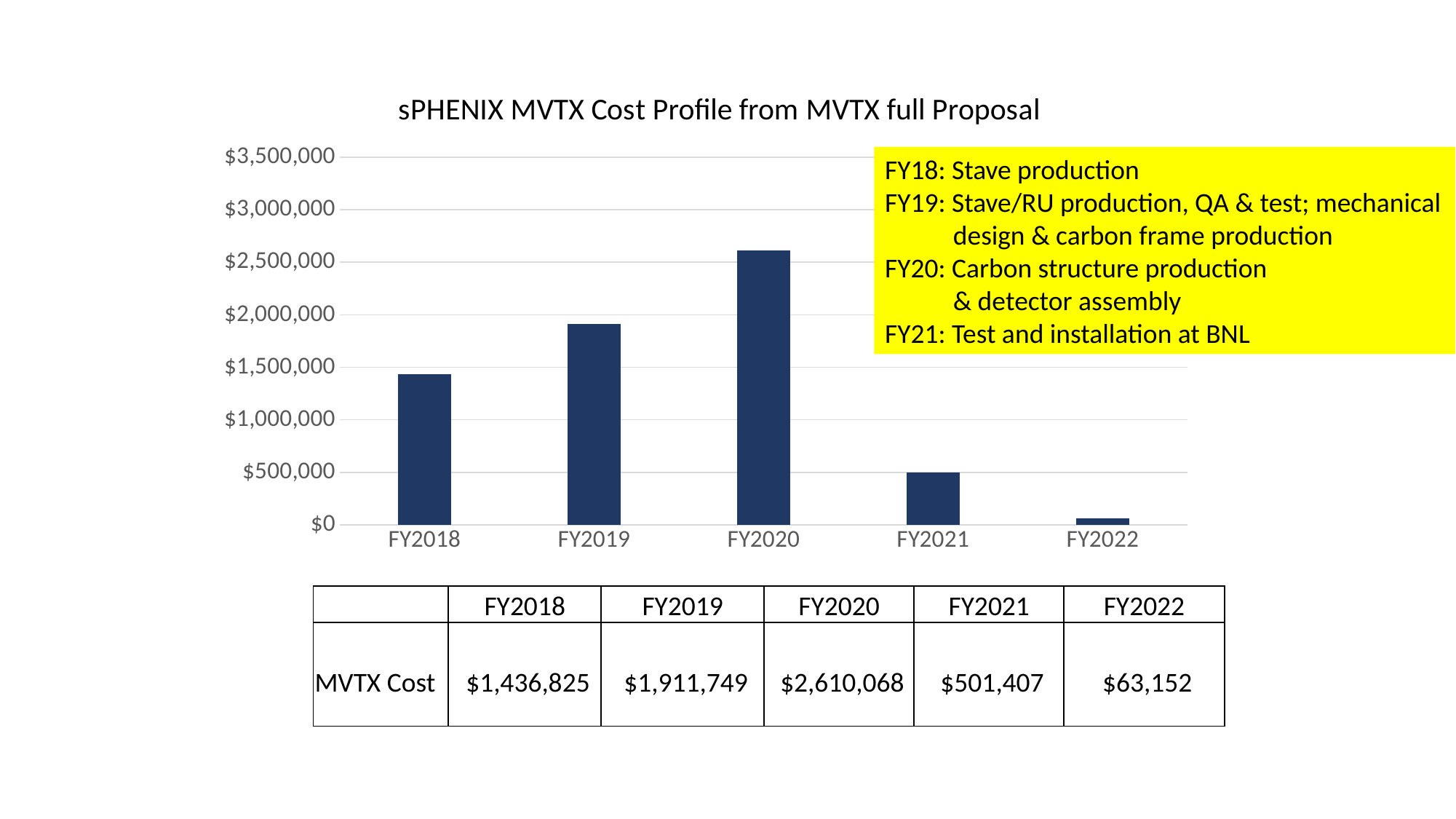
What is the MVTX cost for FY2018? $1,436,825 What is the title of the chart? sPHENIX MVTX Cost Profile from MVTX full Proposal How many fiscal years are shown on the x axis of the chart? 5 Which fiscal year has the lowest MVTX cost? FY2022 What is the difference between the MVTX cost in FY2020 and FY2019? $698,319 What kind of chart is shown on the slide? bar chart Which fiscal year has the highest MVTX cost? FY2020 Is the MVTX cost for FY2019 greater or less than $1,500,000? greater What is the MVTX cost for FY2022? $63,152 What is the MVTX cost for FY2020? $2,610,068 Which is larger, the MVTX cost in FY2019 or in FY2021? FY2019 What is the difference between the MVTX cost in FY2018 and FY2021? $935,418